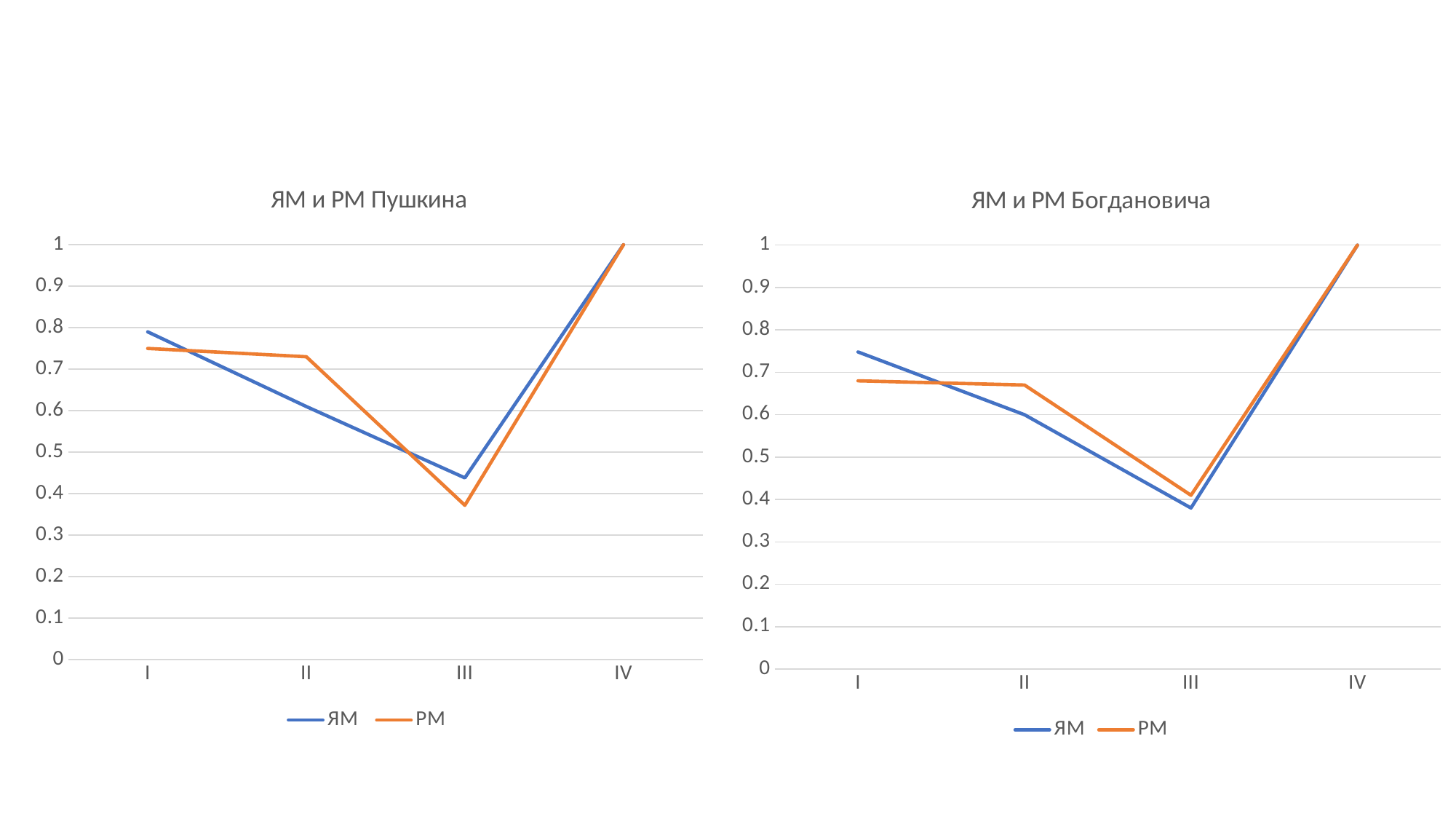
In the chart "ЯМ и РМ Богдановича", what is the value of РМ at IV? 1 In the chart "ЯМ и РМ Богдановича", does the ЯМ line rise or fall from I to III? fall In the chart "ЯМ и РМ Богдановича", at which category is ЯМ highest? IV In the chart "ЯМ и РМ Пушкина", what is the value of ЯМ at IV? 1 In the chart "ЯМ и РМ Пушкина", which series is higher at III, ЯМ or РМ? ЯМ What type of chart is "ЯМ и РМ Пушкина"? line chart In the chart "ЯМ и РМ Пушкина", which series is higher at II, ЯМ or РМ? РМ In the chart "ЯМ и РМ Богдановича", is the value of ЯМ at III greater or less than 0.4? less How many categories are on the x axis of the chart "ЯМ и РМ Богдановича"? 4 In the chart "ЯМ и РМ Пушкина", at which category is РМ lowest? III How many series does the legend of the chart "ЯМ и РМ Пушкина" list? 2 In the chart "ЯМ и РМ Пушкина", is the value of ЯМ at I greater or less than 0.7? greater